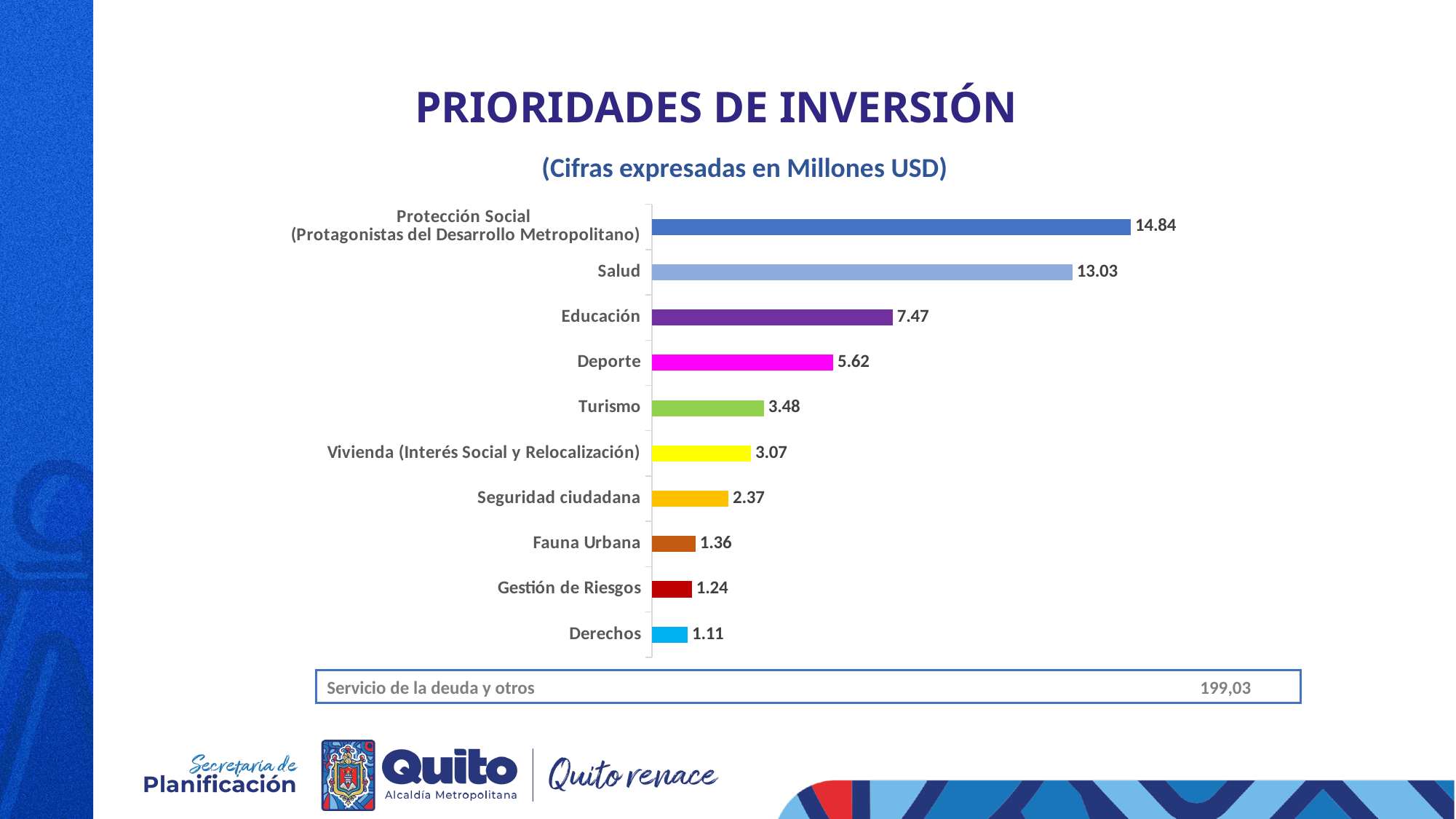
What is the difference between the values for Deporte and Turismo? 2.14 Which is larger, the value for Vivienda (Interés Social y Relocalización) or the value for Fauna Urbana? Vivienda (Interés Social y Relocalización) What is the title of the chart? PRIORIDADES DE INVERSIÓN In what units are the figures in the chart expressed, according to the subtitle? Millones USD How many categories are plotted in the chart? 10 What is the value for Educación? 7.47 What is the difference between the values for Protección Social and Salud? 1.81 What is the value for Salud? 13.03 Which category has the lowest value? Derechos What kind of chart is shown on the slide? Bar chart What is the value for Seguridad ciudadana? 2.37 Which category has the highest value? Protección Social (Protagonistas del Desarrollo Metropolitano)